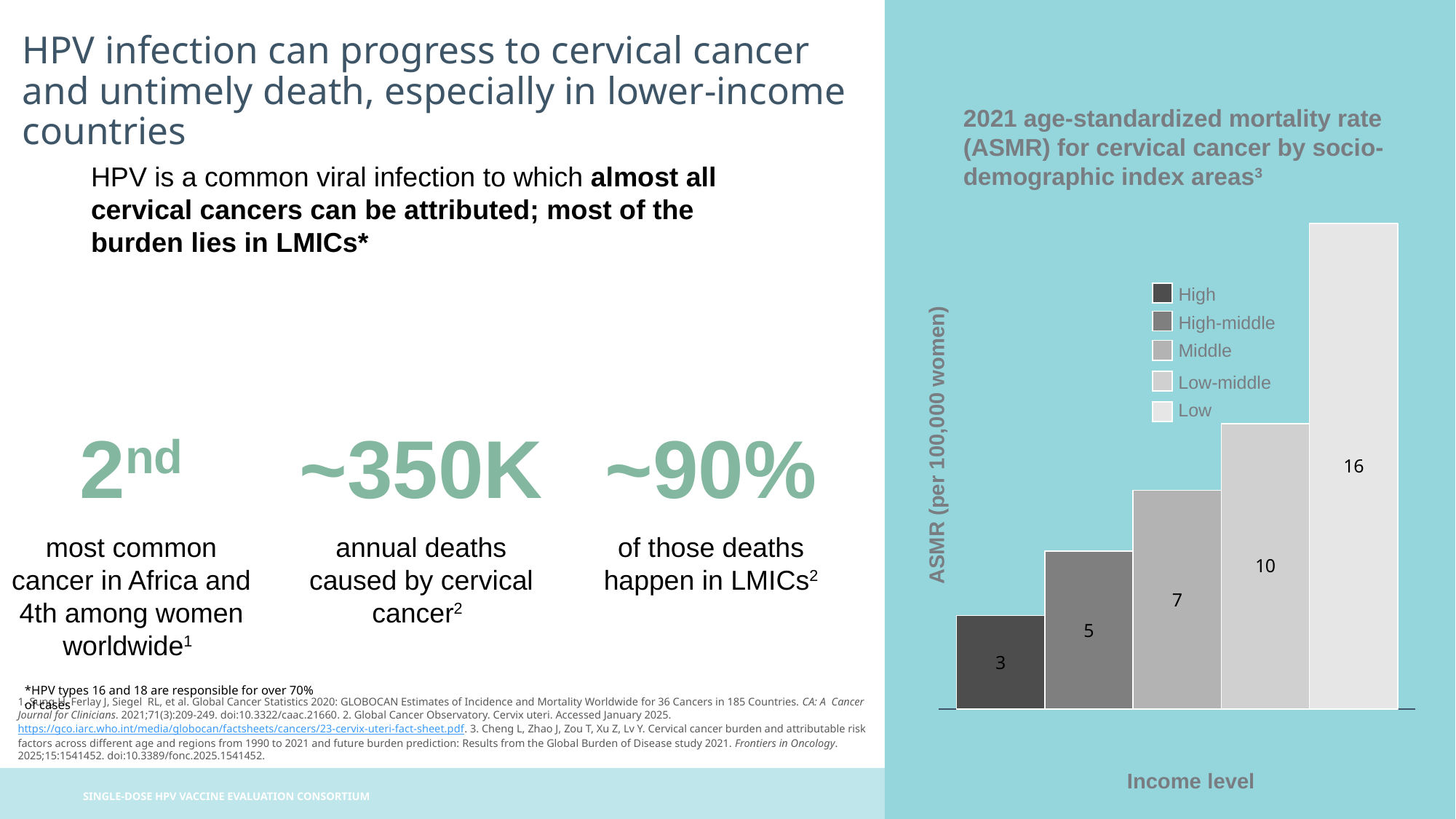
What is the ASMR value for the Low-middle income level? 10 What is the difference in ASMR between the Low and High income levels? 13 What is the ASMR value for the High income level? 3 Which income level has the highest ASMR? Low What is the ASMR value for the Low income level? 16 Do the ASMR values rise or fall from High to Low income level? Rise What is the ASMR value for the Middle income level? 7 What type of chart is shown on the slide? Bar chart How many income levels are shown in the chart? 5 Which income level has the lowest ASMR? High How many entries does the chart legend list? 5 Which has a higher ASMR, High-middle or Low-middle? Low-middle